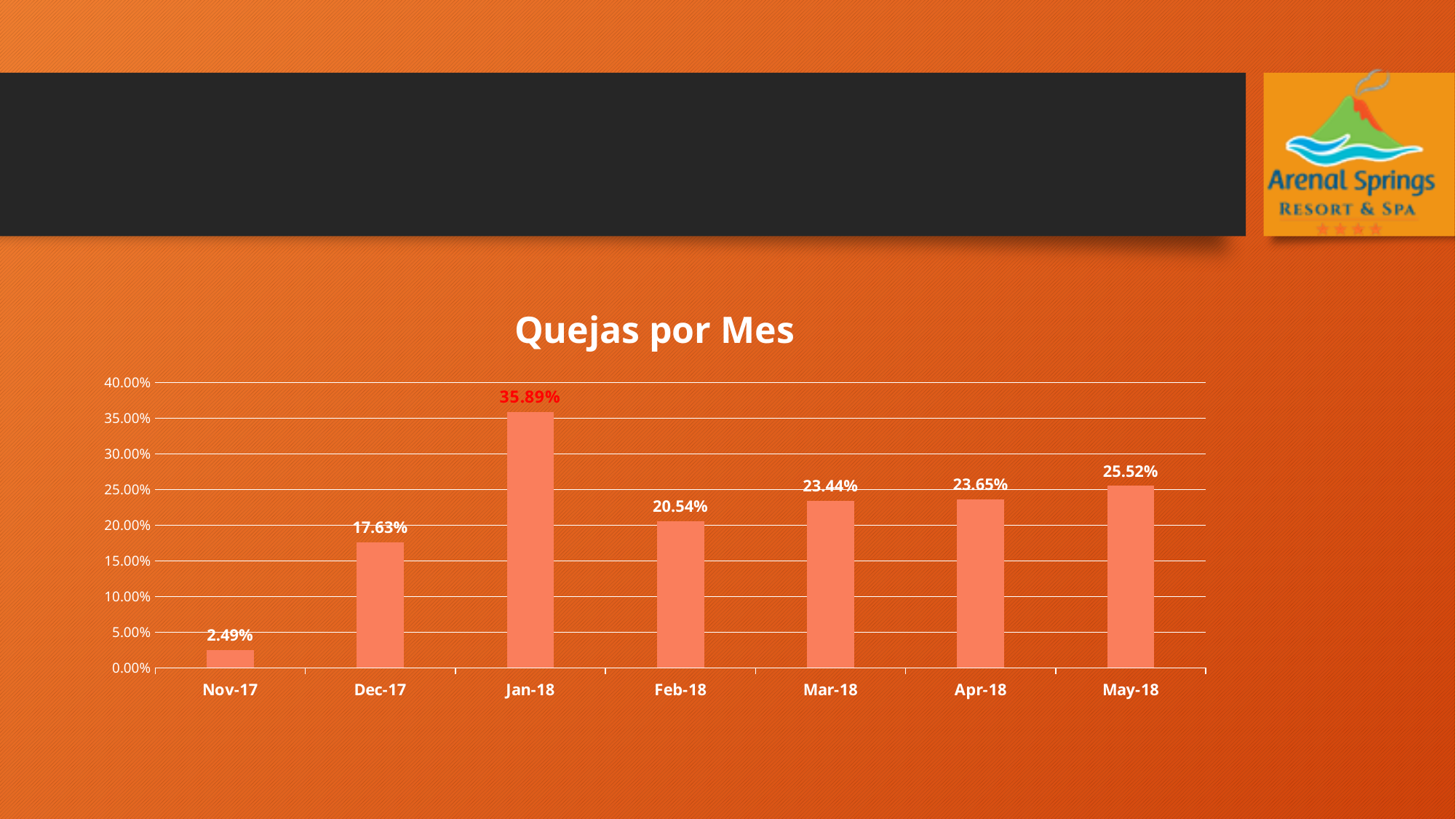
Do the values rise or fall from Feb-18 to May-18? Rise What is the value for Nov-17? 2.49% Which is larger, the value for Dec-17 or the value for May-18? May-18 Is the value for Mar-18 greater or less than 20.00%? greater What is the value for Jan-18? 35.89% How many months are shown on the x axis? 7 Which month has the highest value? Jan-18 What is the title of the chart? Quejas por Mes What is the value for Apr-18? 23.65% What is the difference between the values for Jan-18 and Feb-18? 15.35% Which month has the lowest value? Nov-17 What kind of chart is this? Bar chart